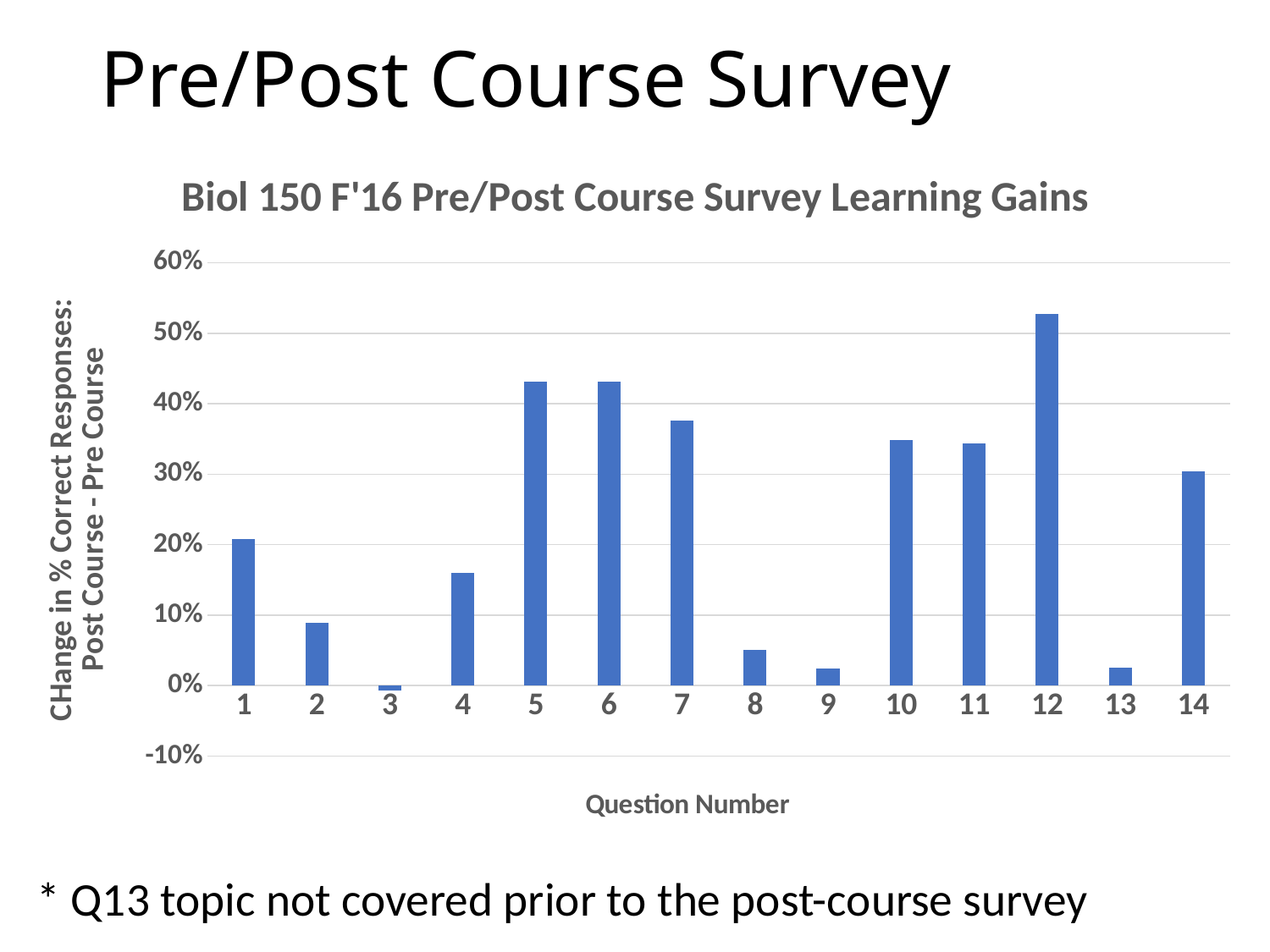
Which has the larger learning gain, question 14 or question 4? Question 14 How many question numbers are plotted on the x axis of the chart? 14 What kind of chart is shown on the slide? Bar chart Is the value for question 8 greater or less than 10%? less Is the value for question 7 greater or less than 40%? less Which question number has the lowest learning gain in the chart? 3 Is the value for question 4 greater or less than 20%? less What is the title of the chart? Biol 150 F'16 Pre/Post Course Survey Learning Gains Which question number has the highest learning gain in the chart? 12 Which has the larger learning gain, question 1 or question 2? Question 1